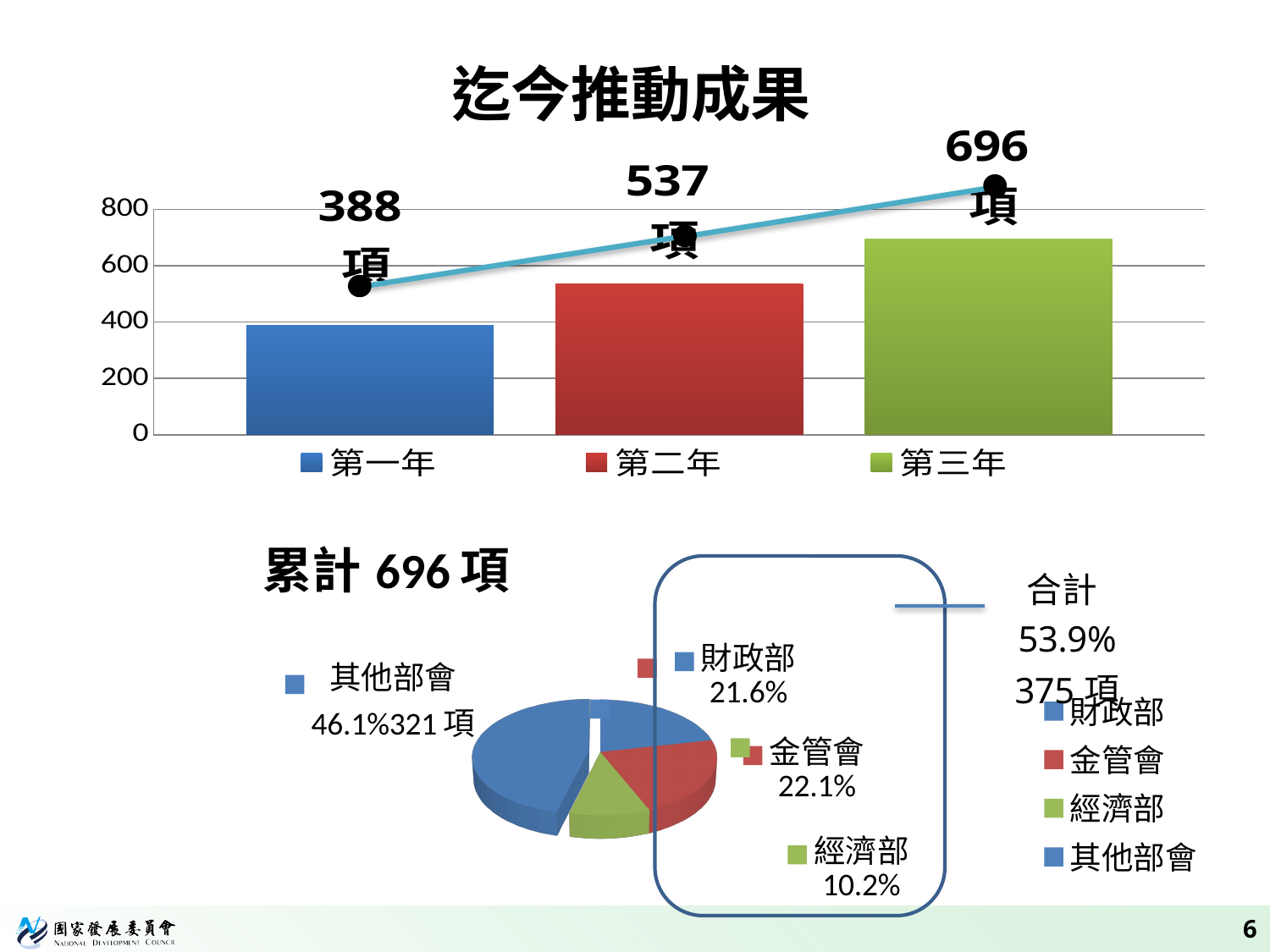
In the top bar chart, is the value for 第二年 greater or less than 400? greater How many entries does the legend of the bottom pie chart list? 4 In the top bar chart, do the values rise or fall from 第一年 to 第三年? rise In the top bar chart, which year has the lowest value? 第一年 In the bottom pie chart (累計 696 項), which slice is the largest? 其他部會 In the top bar chart, what is the difference between the values for 第三年 and 第一年? 308 What kind of chart is the top chart on the slide? bar chart In the top bar chart, what is the value for 第一年? 388 項 In the bottom pie chart (累計 696 項), what share does 經濟部 have? 10.2% In the top bar chart, what is the value for 第三年? 696 項 In the top bar chart, which year has the highest value? 第三年 In the top bar chart, what is the value for 第二年? 537 項